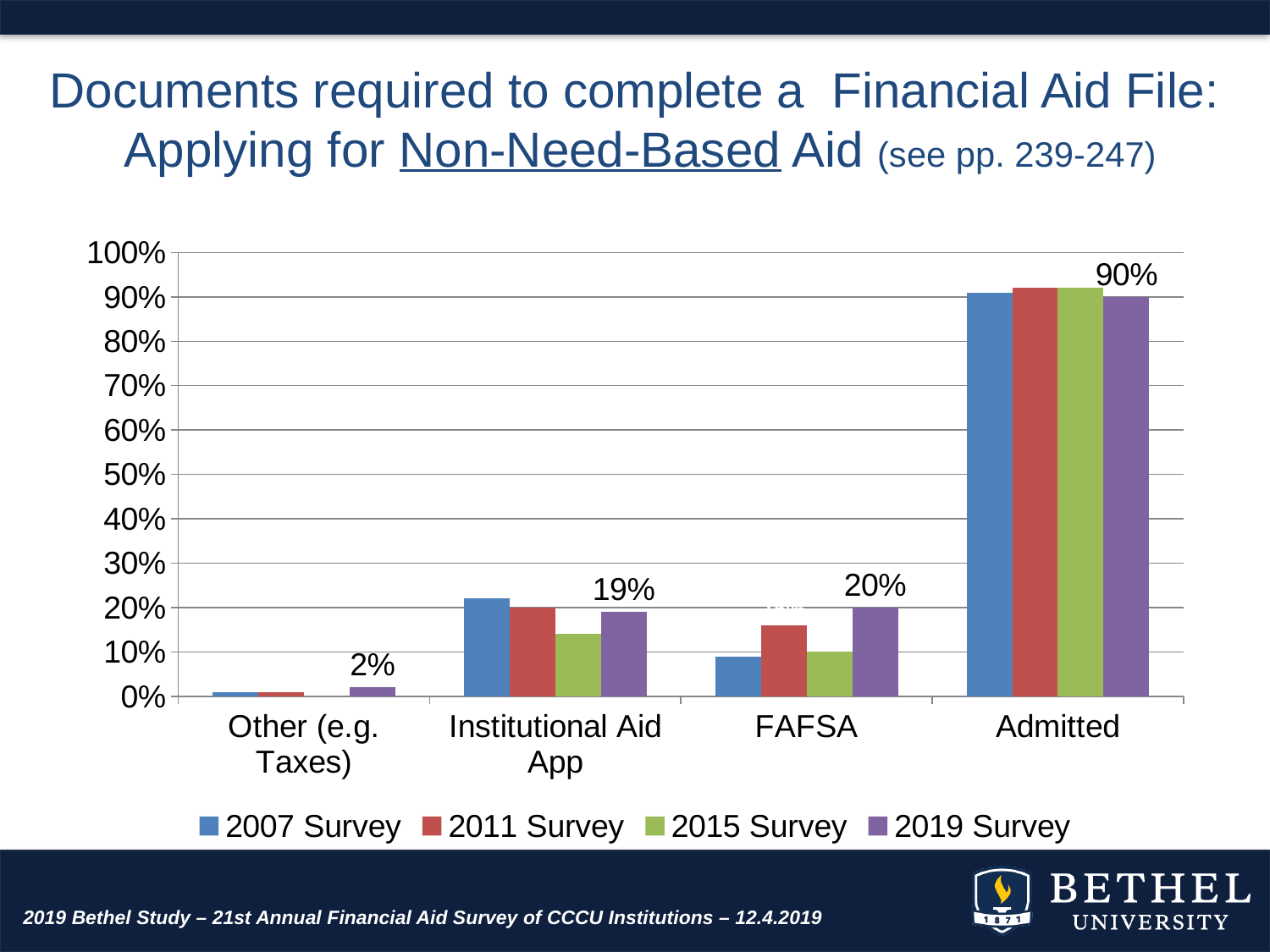
Is the 2015 Survey value for FAFSA greater or less than 20%? less Which category has the lowest values across all surveys? Other (e.g. Taxes) What is the 2019 Survey value for Institutional Aid App? 19% What is the difference between the 2019 Survey values for Admitted and FAFSA? 70% What kind of chart is shown on the slide? Bar chart Which category has the highest values across all surveys? Admitted What is the 2019 Survey value for Other (e.g. Taxes)? 2% Is the 2007 Survey value for Admitted greater or less than 80%? greater What is the 2019 Survey value for FAFSA? 20% How many series does the legend list? 4 What is the 2019 Survey value for Admitted? 90% Which is larger for the 2019 Survey: FAFSA or Other (e.g. Taxes)? FAFSA